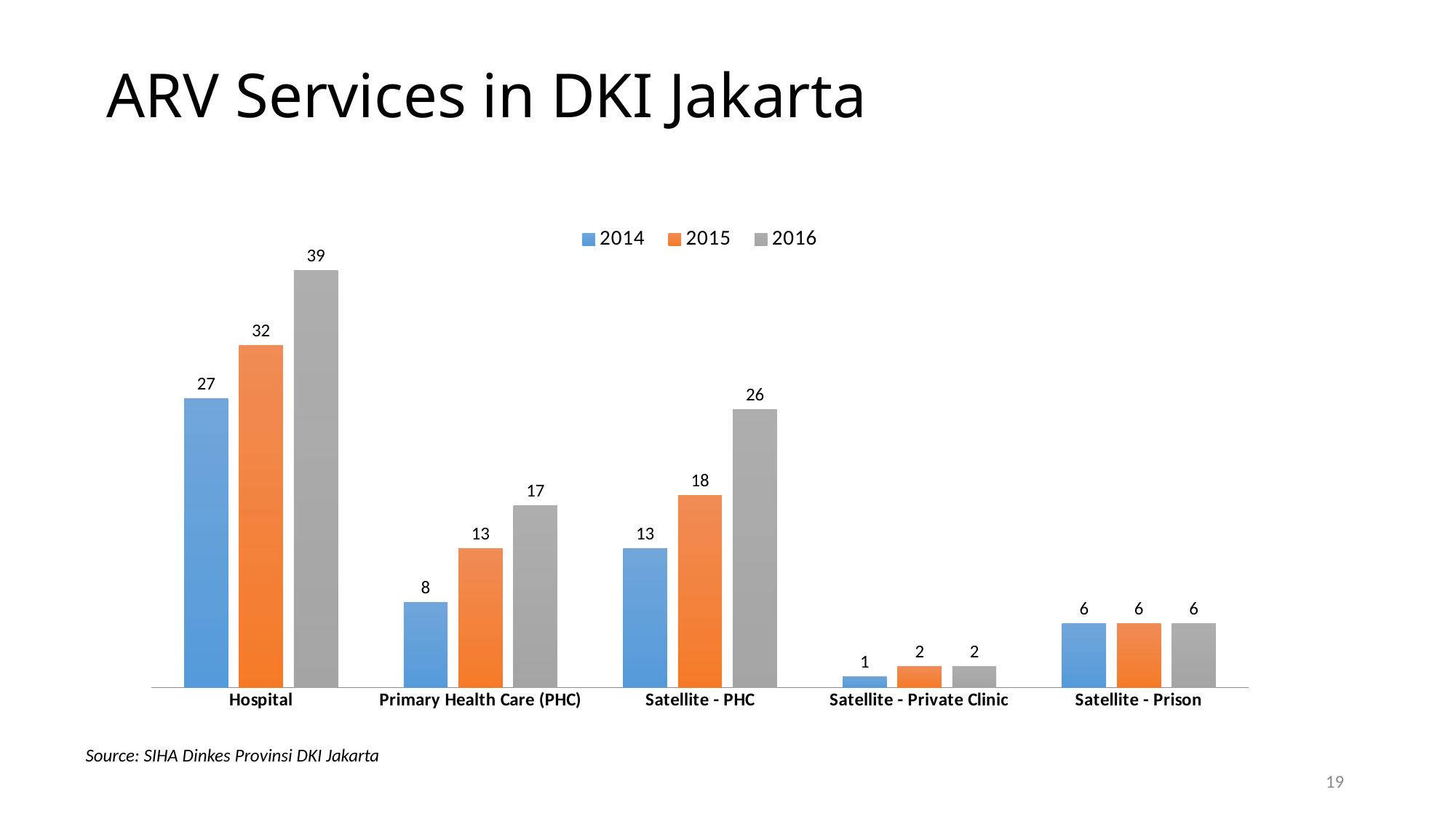
What kind of chart is shown on the slide? Bar chart How many series does the legend list? 3 What is the difference between the 2016 values for Satellite - PHC and Primary Health Care (PHC)? 9 What is the value for Primary Health Care (PHC) in 2014? 8 What is the value for Satellite - PHC in 2015? 18 Which category has the lowest value in 2014? Satellite - Private Clinic Which is larger: the 2015 value for Primary Health Care (PHC) or the 2015 value for Satellite - PHC? Satellite - PHC What is the value for Hospital in 2016? 39 Which category has the highest value in 2016? Hospital What is the difference between the 2016 and 2014 values for Hospital? 12 Do the values for Satellite - Prison rise, fall, or stay the same from 2014 to 2016? Stay the same How many categories are shown on the x axis? 5